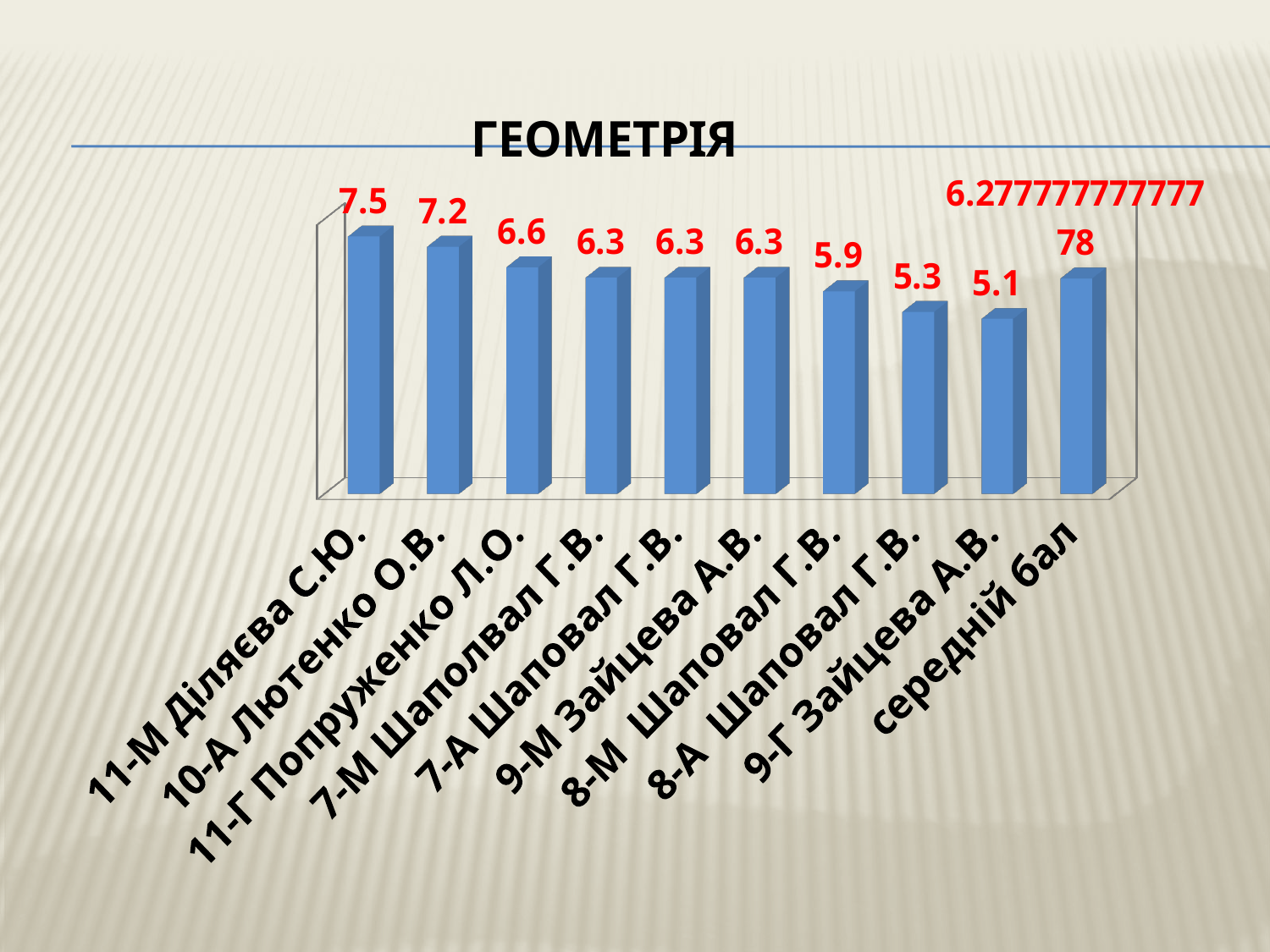
How many bars are shown in the chart? 10 What is the difference between the values for 11-М Діляєва С.Ю. and 9-Г Зайцева А.В.? 2.4 Which category has the lowest value? 9-Г Зайцева А.В. What is the value for 8-М Шаповал Г.В.? 5.9 Which category has the highest value? 11-М Діляєва С.Ю. What is the value shown for середній бал? 6.27777777777778 Which is larger, the value for 10-А Лютенко О.В. or the value for 8-М Шаповал Г.В.? 10-А Лютенко О.В. What is the difference between the values for 11-Г Попруженко Л.О. and 8-А Шаповал Г.В.? 1.3 What is the value for 9-Г Зайцева А.В.? 5.1 What is the value for 10-А Лютенко О.В.? 7.2 What type of chart is shown on the slide? Bar chart What is the value for 11-М Діляєва С.Ю.? 7.5